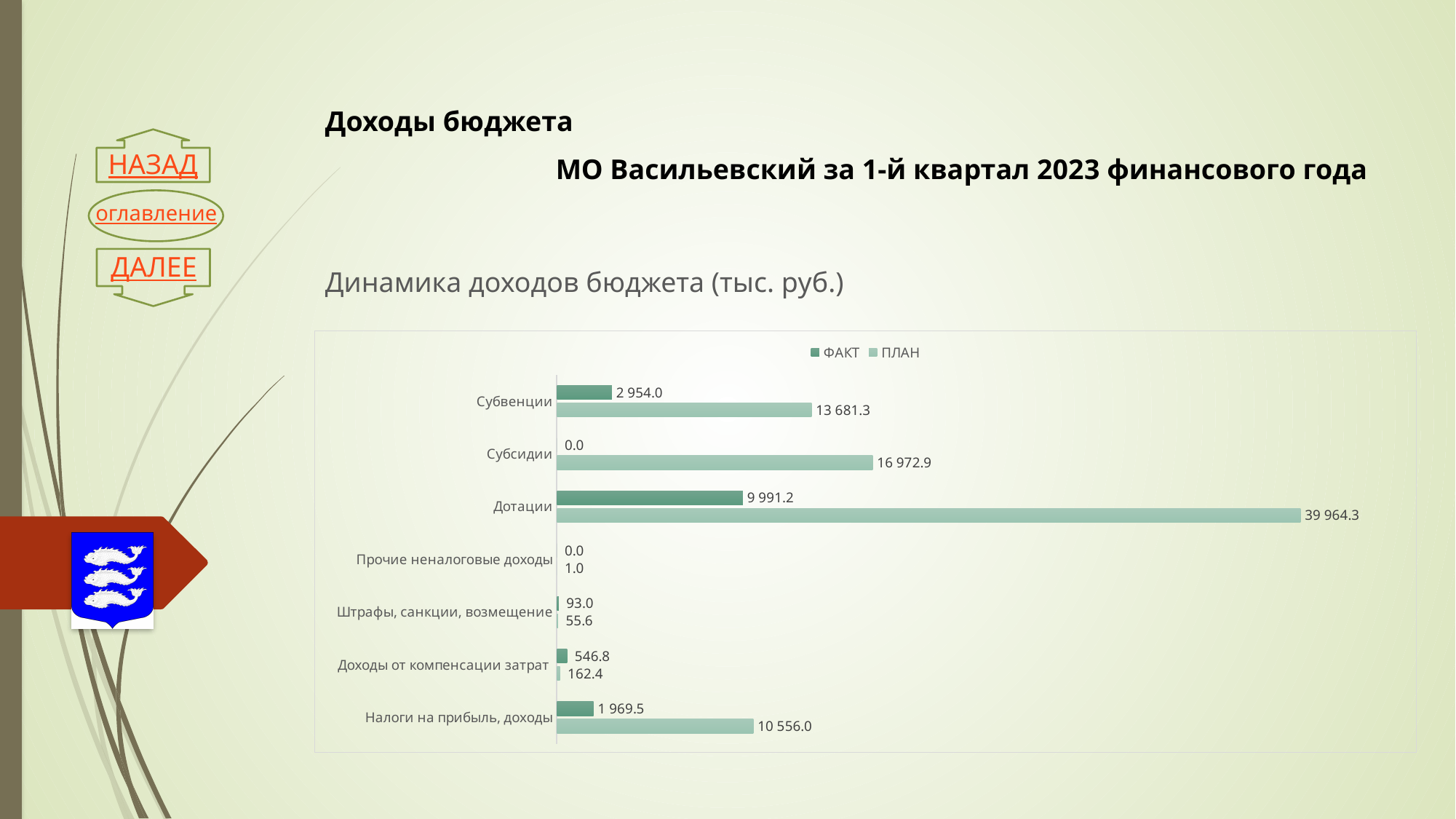
What is the ПЛАН value for Налоги на прибыль, доходы? 10 556.0 What kind of chart is shown on the slide? Bar chart Which category has the lowest ПЛАН value? Прочие неналоговые доходы What is the difference between the ПЛАН and ФАКТ values for Дотации? 29 973.1 Which is larger for Доходы от компенсации затрат: the ФАКТ value or the ПЛАН value? ФАКТ What is the ПЛАН value for Дотации? 39 964.3 Which category has the highest ПЛАН value? Дотации What is the ФАКТ value for Субвенции? 2 954.0 How many series does the legend list? 2 What are the two series named in the chart legend? ФАКТ and ПЛАН How many categories are shown on the chart? 7 What is the ФАКТ value for Штрафы, санкции, возмещение? 93.0